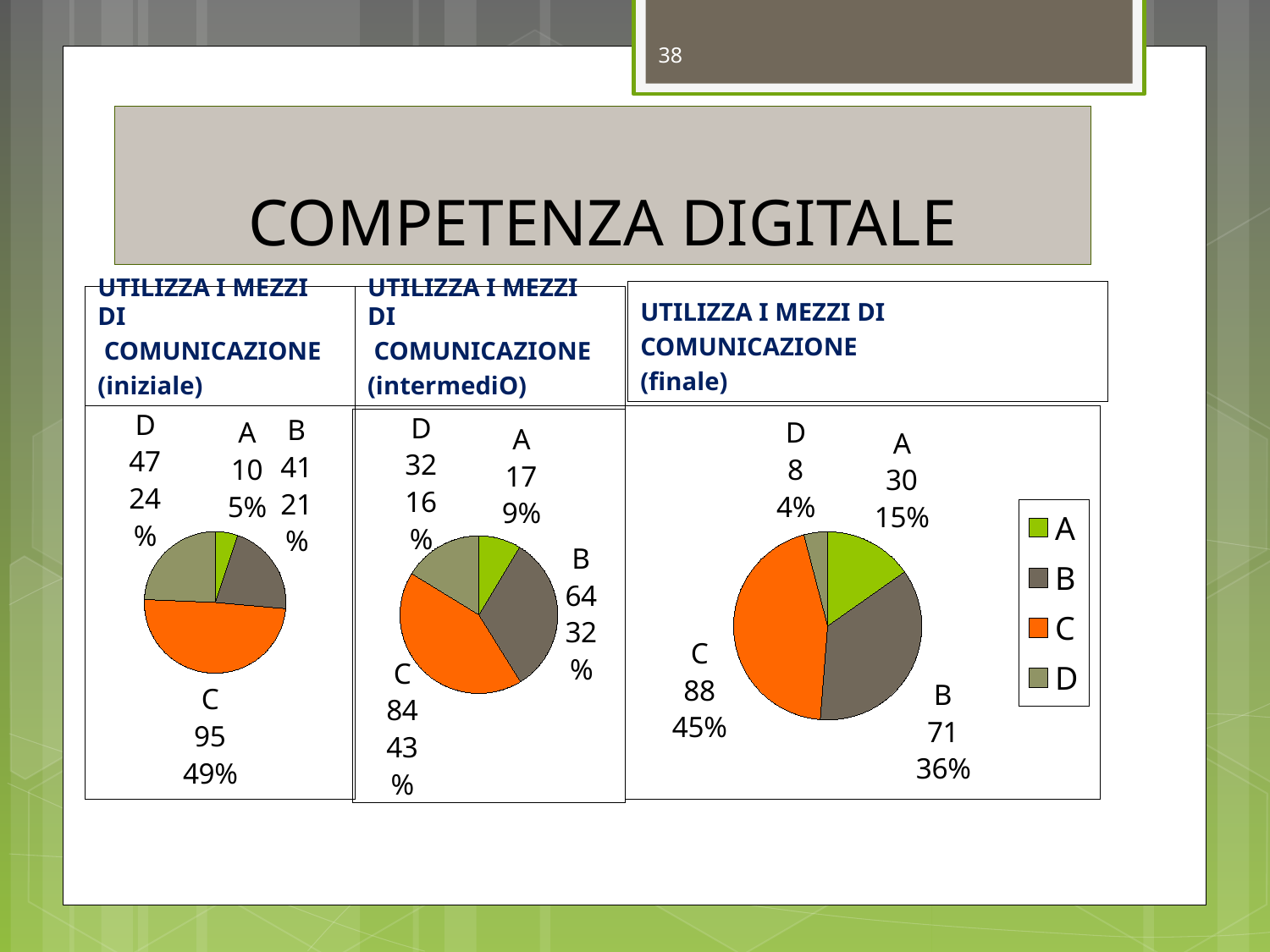
In the 'UTILIZZA I MEZZI DI COMUNICAZIONE (iniziale)' pie chart, what value is shown for category C? 95 In the 'UTILIZZA I MEZZI DI COMUNICAZIONE (finale)' pie chart, what percentage share does category B have? 36% In the 'UTILIZZA I MEZZI DI COMUNICAZIONE (intermediO)' pie chart, what value is shown for category B? 64 In the 'UTILIZZA I MEZZI DI COMUNICAZIONE (intermediO)' pie chart, what percentage share does category D have? 16% What type of chart is used for 'UTILIZZA I MEZZI DI COMUNICAZIONE (iniziale)'? Pie chart In the 'UTILIZZA I MEZZI DI COMUNICAZIONE (finale)' pie chart, which is larger, the value for A or the value for D? A In the 'UTILIZZA I MEZZI DI COMUNICAZIONE (iniziale)' pie chart, what percentage share does category A have? 5% In the 'UTILIZZA I MEZZI DI COMUNICAZIONE (finale)' pie chart, what value is shown for category D? 8 In the 'UTILIZZA I MEZZI DI COMUNICAZIONE (finale)' pie chart, what is the difference between the values for C and B? 17 How many categories does the 'UTILIZZA I MEZZI DI COMUNICAZIONE (finale)' pie chart show? 4 In the 'UTILIZZA I MEZZI DI COMUNICAZIONE (intermediO)' pie chart, which category has the smallest slice? A In the 'UTILIZZA I MEZZI DI COMUNICAZIONE (iniziale)' pie chart, which category has the largest slice? C